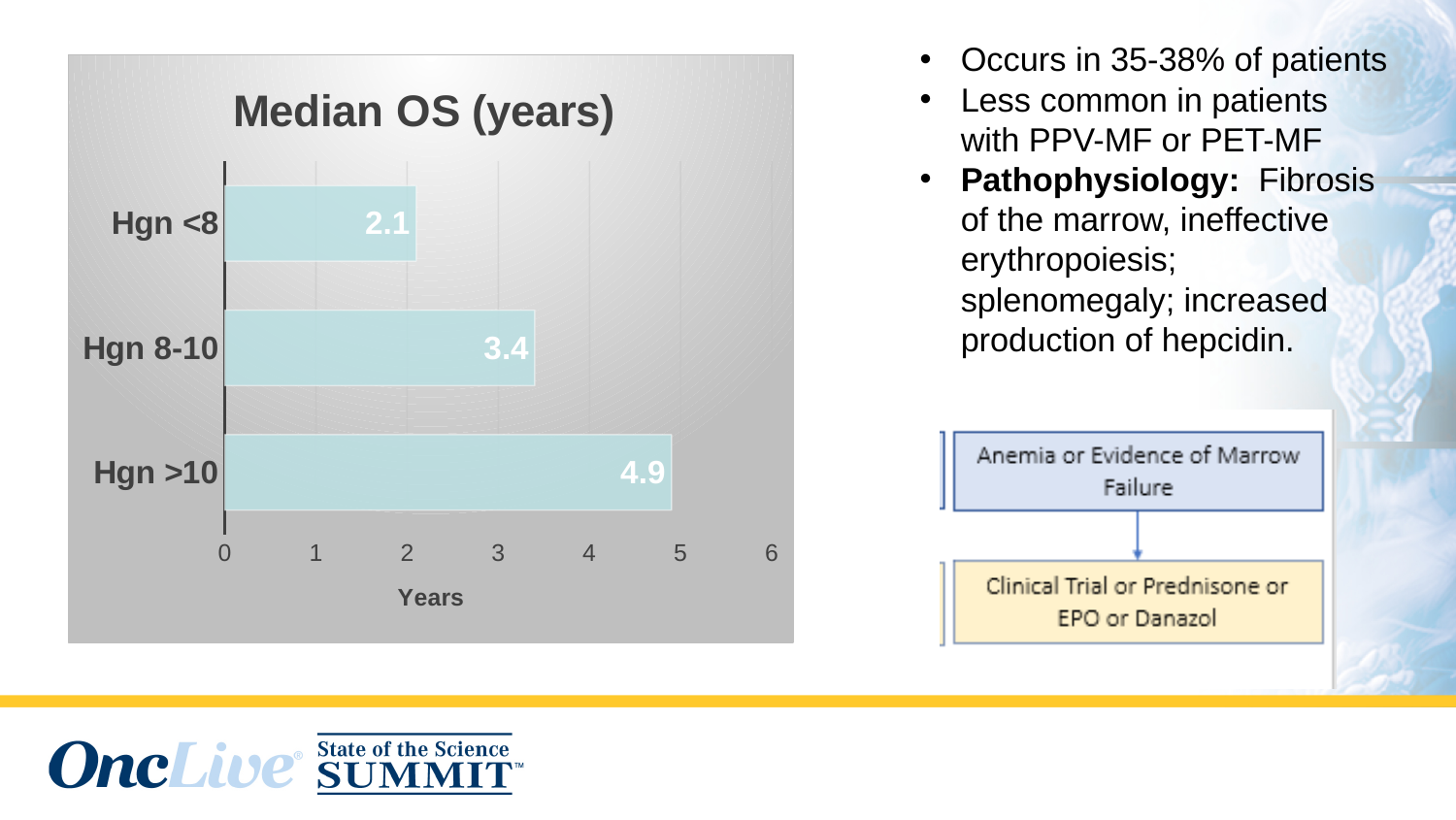
What is the difference in median OS between Hgn 8-10 and Hgn <8? 1.3 What is the title of the chart? Median OS (years) Is the median OS for Hgn >10 greater or less than 4? greater What is the difference in median OS between Hgn >10 and Hgn <8? 2.8 What is the median OS in years for the Hgn <8 category? 2.1 Which has a larger median OS, Hgn 8-10 or Hgn >10? Hgn >10 Which category has the lowest median OS? Hgn <8 What is the median OS in years for the Hgn >10 category? 4.9 How many categories are shown in the chart? 3 What type of chart is used to show median OS? Bar chart Which category has the highest median OS? Hgn >10 What is the median OS in years for the Hgn 8-10 category? 3.4